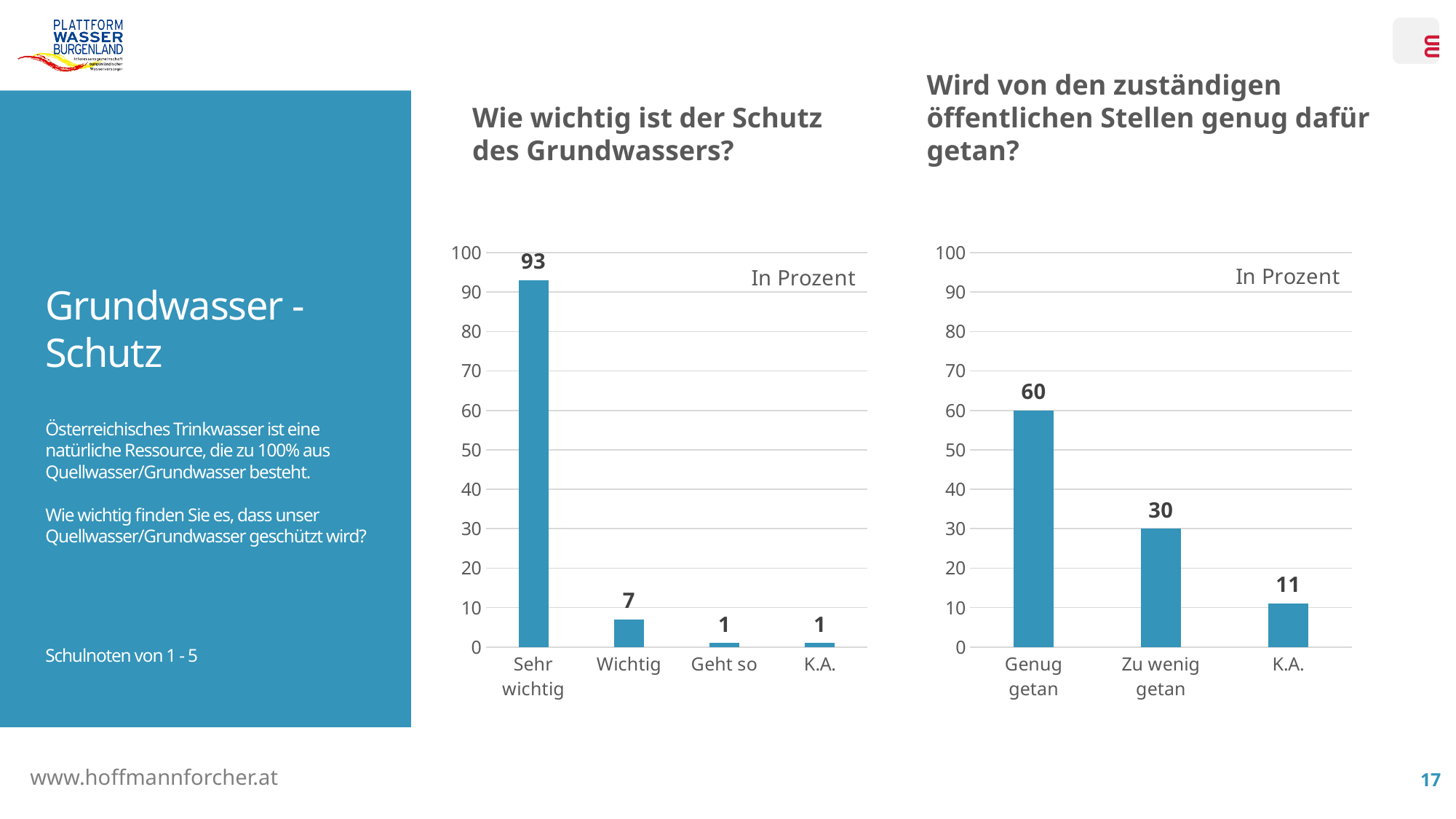
In the chart 'Wie wichtig ist der Schutz des Grundwassers?', how many categories are shown on the x axis? 4 In the chart 'Wie wichtig ist der Schutz des Grundwassers?', which category has the highest value? Sehr wichtig In the chart 'Wie wichtig ist der Schutz des Grundwassers?', what is the difference between 'Sehr wichtig' and 'Wichtig'? 86 In the chart 'Wird von den zuständigen öffentlichen Stellen genug dafür getan?', what is the value for 'K.A.'? 11 In the chart 'Wird von den zuständigen öffentlichen Stellen genug dafür getan?', do the values rise or fall from left to right along the x axis? Fall In the chart 'Wird von den zuständigen öffentlichen Stellen genug dafür getan?', what is the difference between 'Genug getan' and 'Zu wenig getan'? 30 In the chart 'Wird von den zuständigen öffentlichen Stellen genug dafür getan?', which category has the lowest value? K.A. In the chart 'Wird von den zuständigen öffentlichen Stellen genug dafür getan?', what is the value for 'Zu wenig getan'? 30 In the chart 'Wie wichtig ist der Schutz des Grundwassers?', what is the value for 'Sehr wichtig'? 93 In the chart 'Wird von den zuständigen öffentlichen Stellen genug dafür getan?', which is larger: 'Genug getan' or 'Zu wenig getan'? Genug getan In the chart 'Wie wichtig ist der Schutz des Grundwassers?', what is the value for 'Wichtig'? 7 What kind of chart is the chart on the right, 'Wird von den zuständigen öffentlichen Stellen genug dafür getan?'? Bar chart